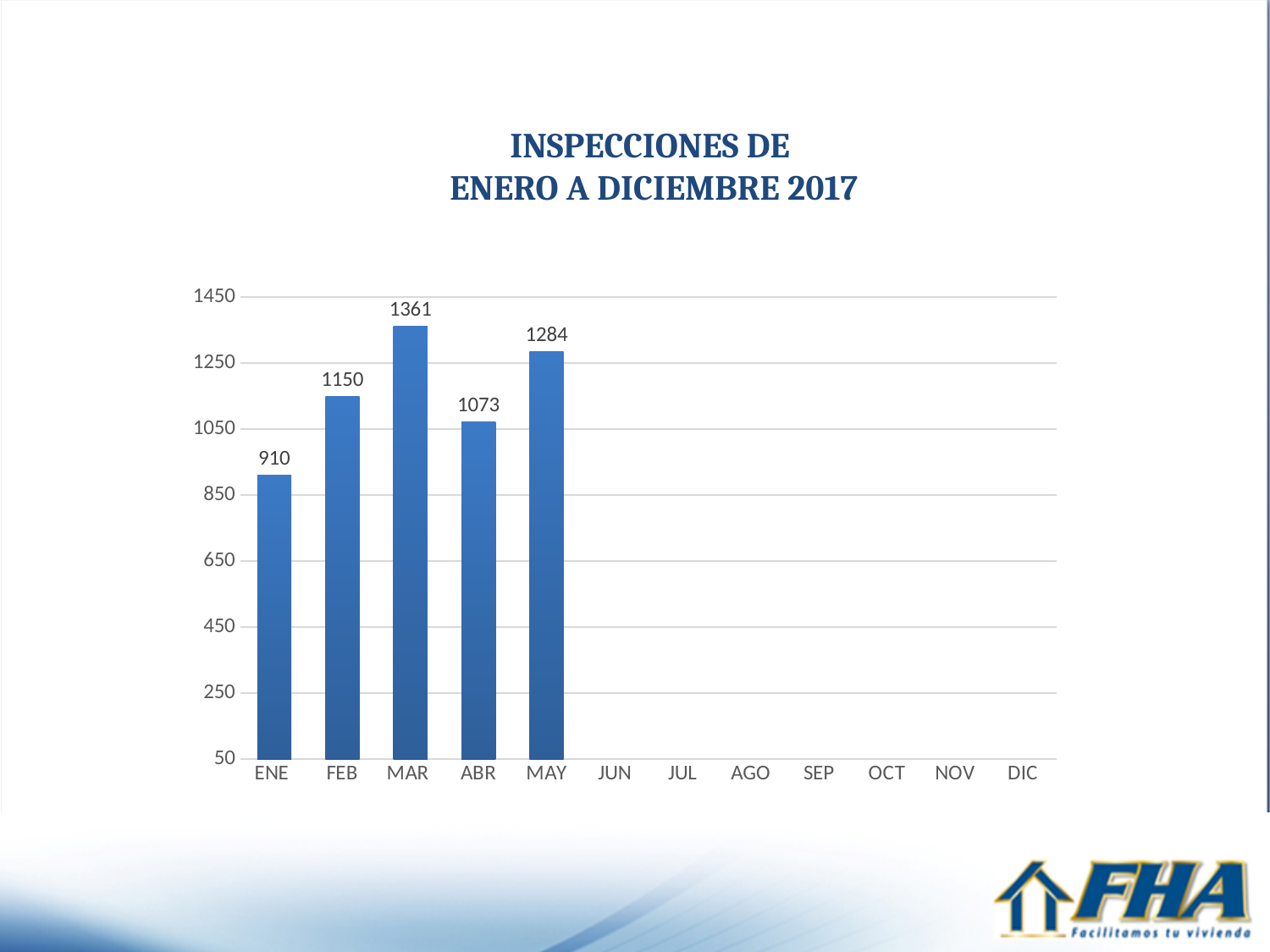
Which is larger, the value for FEB or the value for ABR? FEB How many months have a bar plotted? 5 What is the value for ABR? 1073 Is the value for MAY greater or less than 1250? greater What is the difference between the values for MAR and ENE? 451 Which month with a plotted bar has the lowest value? ENE What is the difference between the values for MAY and ABR? 211 What is the title of the chart? INSPECCIONES DE ENERO A DICIEMBRE 2017 What is the value for ENE? 910 What kind of chart is shown? bar chart Which month has the highest value? MAR What is the value for MAR? 1361